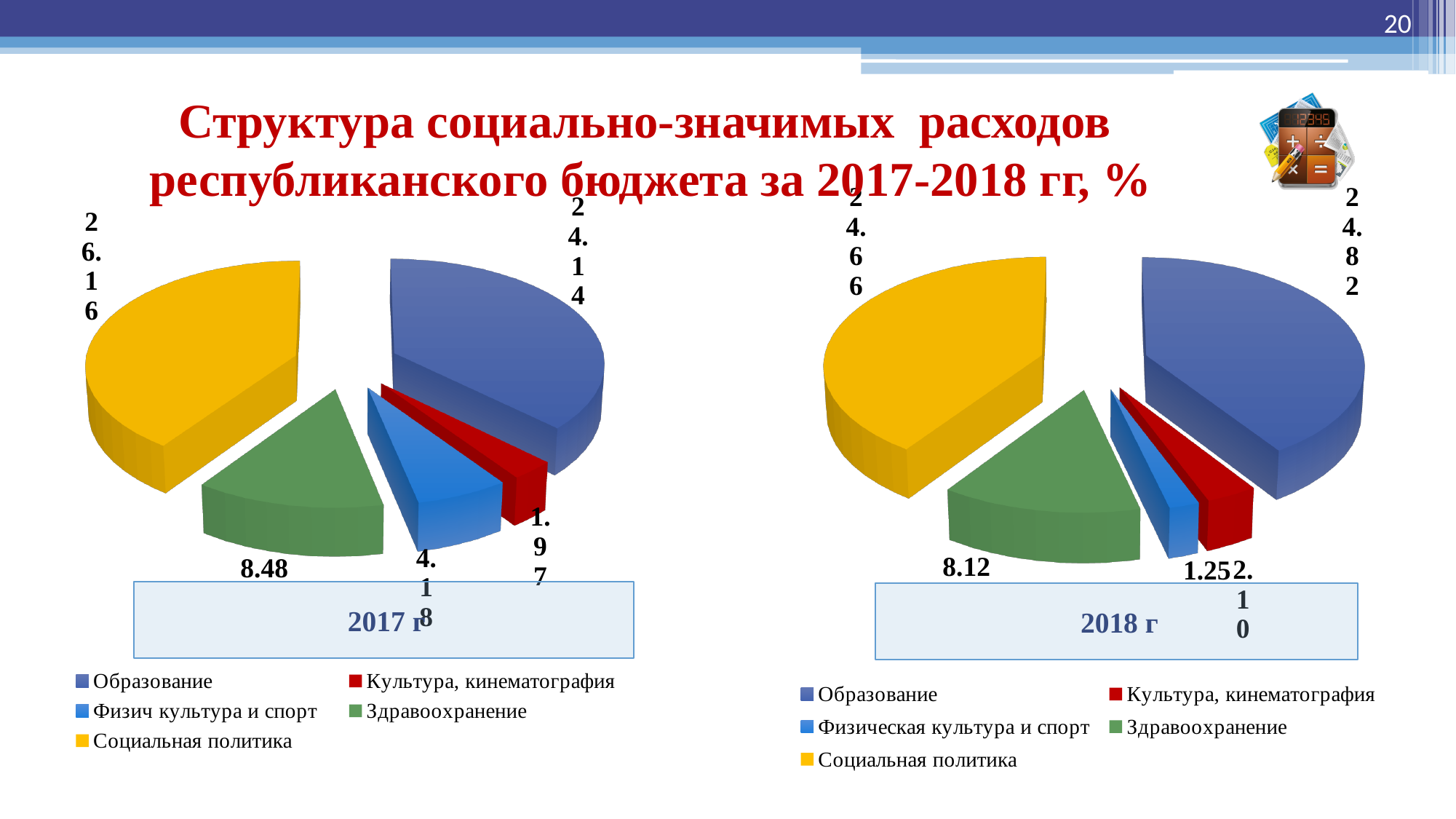
In the 2017 г chart, what is the value for Здравоохранение? 8.48 What type of chart is used for the 2017 г data? Pie chart In the 2018 г chart, what is the value for Физическая культура и спорт? 1.25 In the 2018 г chart, which category has the smallest value? Физическая культура и спорт How many categories does the legend of the 2018 г chart list? 5 In the 2017 г chart, which category has the smallest value? Культура, кинематография In the 2017 г chart, what is the value for Социальная политика? 26.16 In the 2017 г chart, what is the value for Образование? 24.14 What is the difference between the Здравоохранение values in the 2017 г chart and the 2018 г chart? 0.36 In the 2018 г chart, what is the value for Образование? 24.82 In the 2018 г chart, what is the value for Здравоохранение? 8.12 In the 2017 г chart, which category has the largest value? Социальная политика